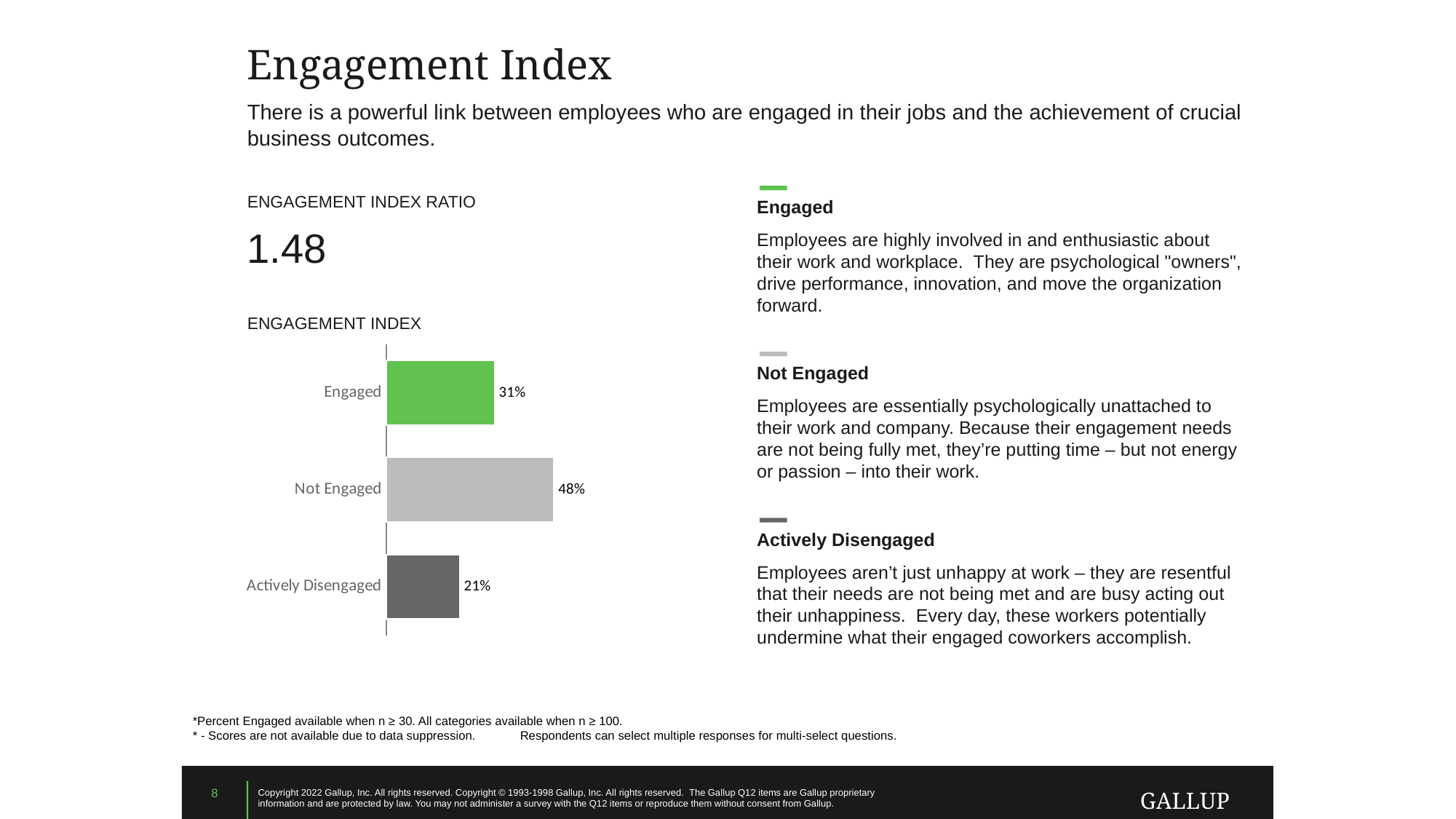
What percentage of employees are Actively Disengaged according to the Engagement Index chart? 21% Which is larger in the Engagement Index chart, Engaged or Actively Disengaged? Engaged What is the Engagement Index Ratio shown on the slide? 1.48 What percentage of employees are Not Engaged according to the Engagement Index chart? 48% What is the difference between the Engaged and Actively Disengaged percentages in the Engagement Index chart? 10% How many categories are shown in the Engagement Index chart? 3 What kind of chart is the Engagement Index chart? Bar chart What is the difference between the Not Engaged and Engaged percentages in the Engagement Index chart? 17% What colour is the Engaged bar in the Engagement Index chart? Green Which category has the highest value in the Engagement Index chart? Not Engaged Which category has the lowest value in the Engagement Index chart? Actively Disengaged What percentage of employees are Engaged according to the Engagement Index chart? 31%